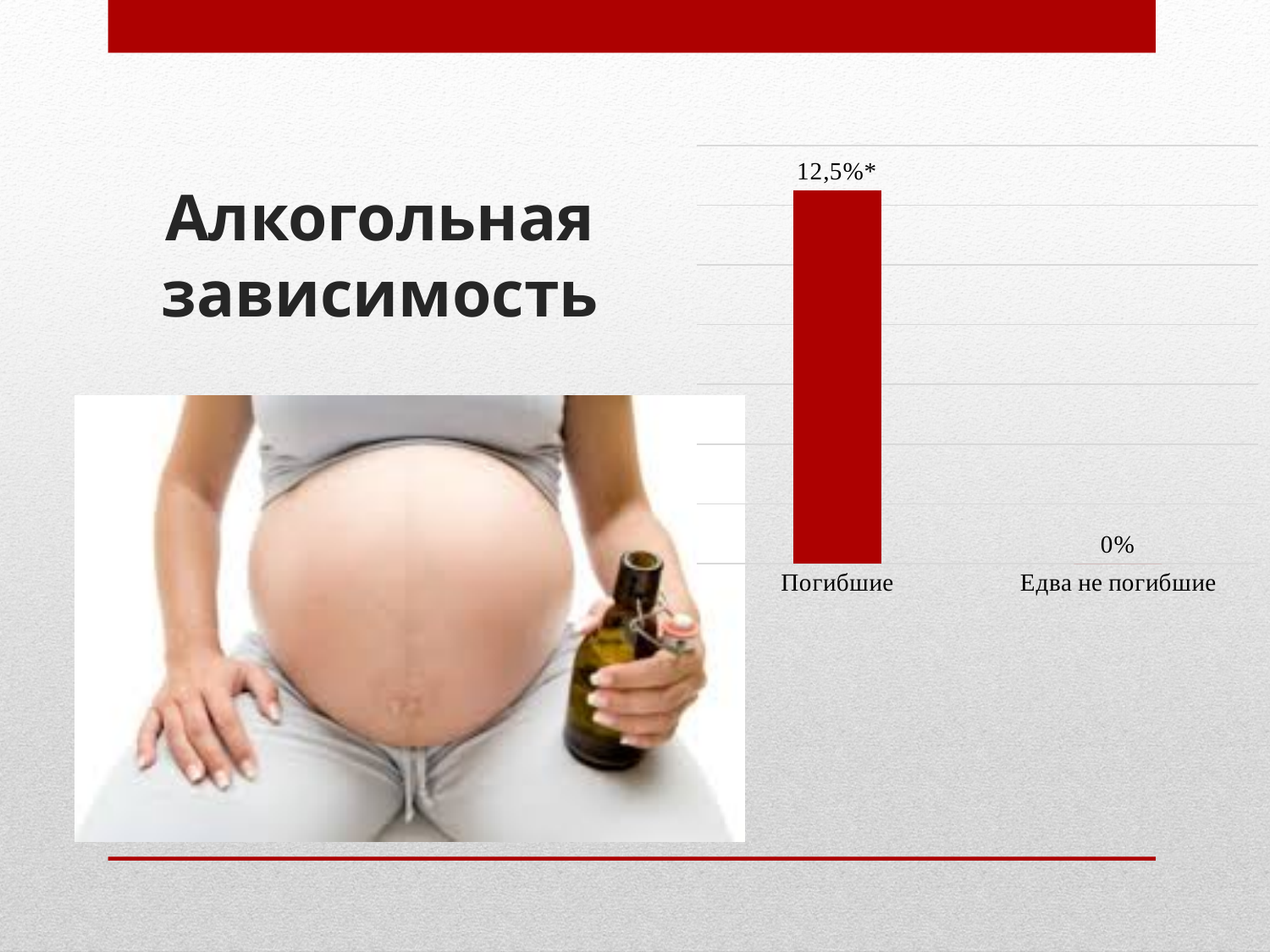
What is the title text on the slide next to the chart? Алкогольная зависимость How many categories are shown on the x axis of the bar chart? 2 What is the value shown for the category "Погибшие" in the bar chart? 12,5%* Which category has the highest value in the bar chart? Погибшие What colour is the bar in the chart? red Do the values in the bar chart rise or fall from left to right along the x axis? fall Which is larger in the bar chart: the value for "Погибшие" or the value for "Едва не погибшие"? Погибшие What is the difference between the values for "Погибшие" and "Едва не погибшие" in the bar chart? 12,5% Which category has the lowest value in the bar chart? Едва не погибшие What kind of chart is shown on the slide? bar chart What is the value shown for the category "Едва не погибшие" in the bar chart? 0%